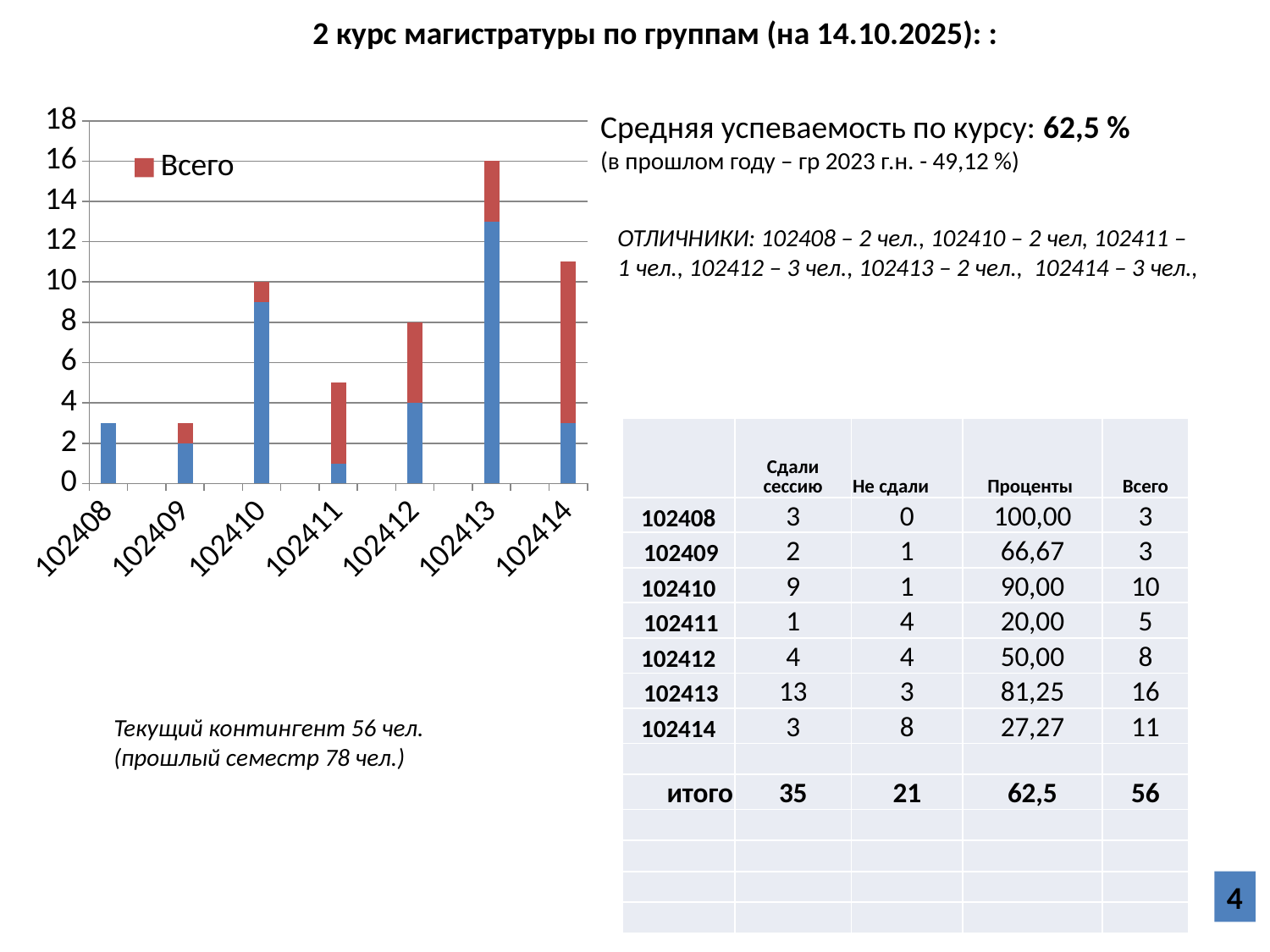
What kind of chart is shown on the slide? bar chart Which group has the tallest bar in the chart? 102413 Is the total bar height for group 102414 greater or less than 8? greater How many groups (categories) are shown on the x axis of the chart? 7 What is the total bar height for group 102410? 10 What entry does the chart legend show? Всего What is the difference between the total bar heights of 102413 and 102412? 8 What is the total bar height for group 102412? 8 Is the total bar height for group 102411 greater or less than 6? less Which bar is taller, 102413 or 102410? 102413 What is the total bar height for group 102413? 16 Which bar is taller, 102414 or 102412? 102414